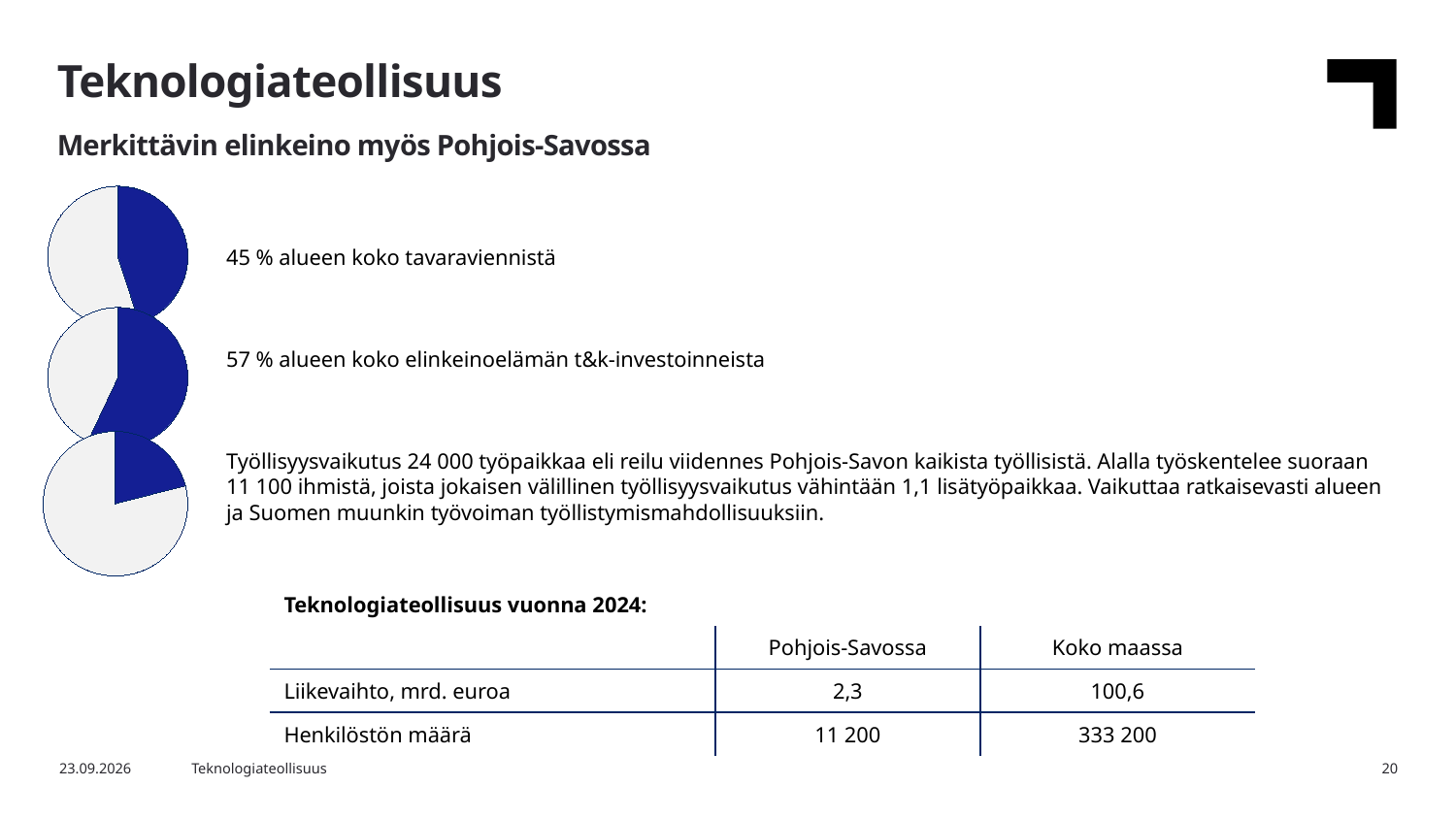
How many pie charts are on the slide? 3 Which pie chart has the larger blue slice, the top one or the middle one? the middle one What does the top pie chart's blue slice represent, according to the text beside it? 45 % alueen koko tavaraviennistä In the middle pie chart, what share of the pie does the blue slice represent, according to the text next to it? 57 % Which of the three pie charts has the smallest blue slice? the bottom one What colour is the highlighted slice in the pie charts? blue How many slices does each pie chart have? 2 What kind of chart is shown at the top left of the slide? pie chart In the top pie chart, what share of the pie does the blue slice represent, according to the text next to it? 45 % Is the blue slice in the middle pie chart greater or less than half of the pie? greater Which of the three pie charts has the largest blue slice? the middle one Is the blue slice in the bottom pie chart greater or less than half of the pie? less